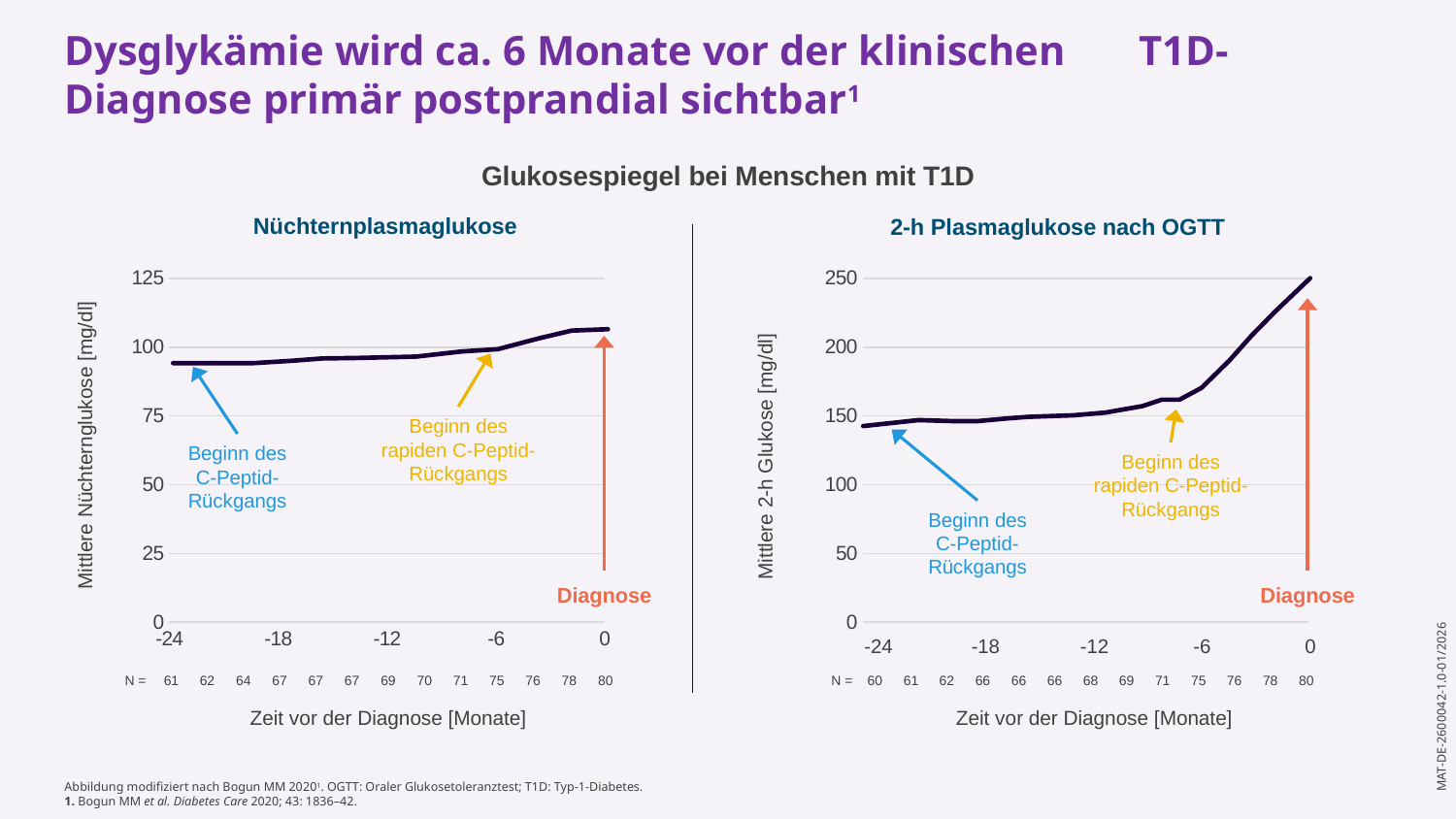
In the left chart (Nüchternplasmaglukose), do the values rise or fall from -24 to 0 months? rise In the left chart (Nüchternplasmaglukose), is the value at 0 months (Diagnose) greater or less than 100? greater What is the y-axis label of the right chart (2-h Plasmaglukose nach OGTT)? Mittlere 2-h Glukose [mg/dl] In the right chart (2-h Plasmaglukose nach OGTT), is the value at -6 months greater or less than 150? greater What kind of chart is the left chart titled "Nüchternplasmaglukose"? line chart What is the overall title shown above the two charts? Glukosespiegel bei Menschen mit T1D In the right chart (2-h Plasmaglukose nach OGTT), which is larger: the value at -24 months or the value at 0 months? 0 months In the left chart (Nüchternplasmaglukose), is the value at -24 months greater or less than 100? less In the right chart (2-h Plasmaglukose nach OGTT), do the values rise or fall as time approaches the diagnosis (from -24 to 0 months)? rise In the right chart (2-h Plasmaglukose nach OGTT), at which time point is the glucose value highest? 0 (Diagnose)